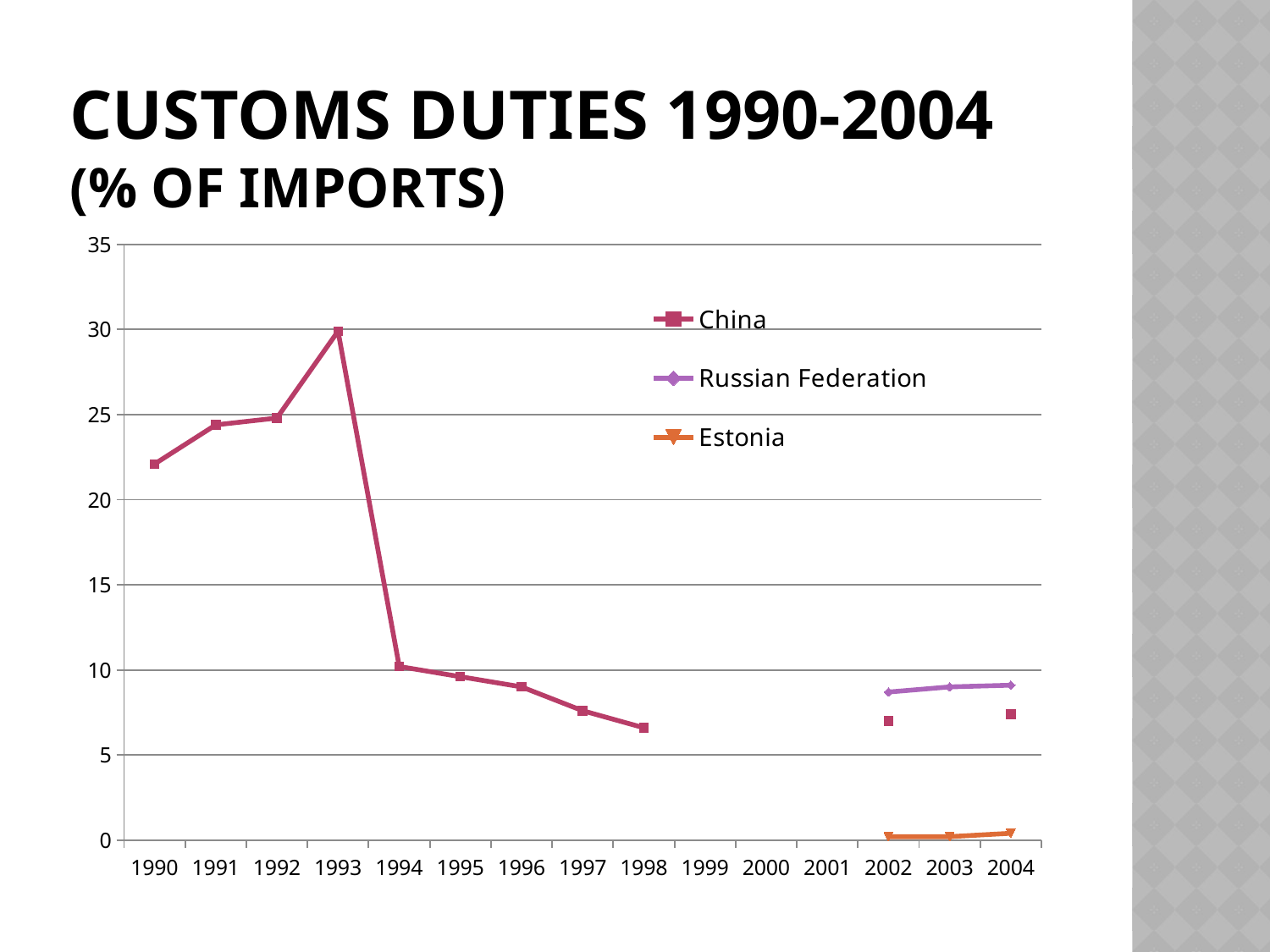
How many series does the legend list? 3 Is the value for China in 1994 greater or less than 15? less In 2004, which series has the larger value: Russian Federation or Estonia? Russian Federation In which year does the China series reach its highest value? 1993 Is the value for Estonia in 2003 greater or less than 5? less How many years are labelled on the x axis? 15 Which is larger for China: the value in 1990 or the value in 1993? 1993 Is the value for China in 1993 greater or less than 25? greater In 2002, which series has the larger value: China or Russian Federation? Russian Federation Does the China series rise or fall from 1994 to 1998? fall What kind of chart is shown on the slide? line chart Which series are listed in the legend? China, Russian Federation, Estonia